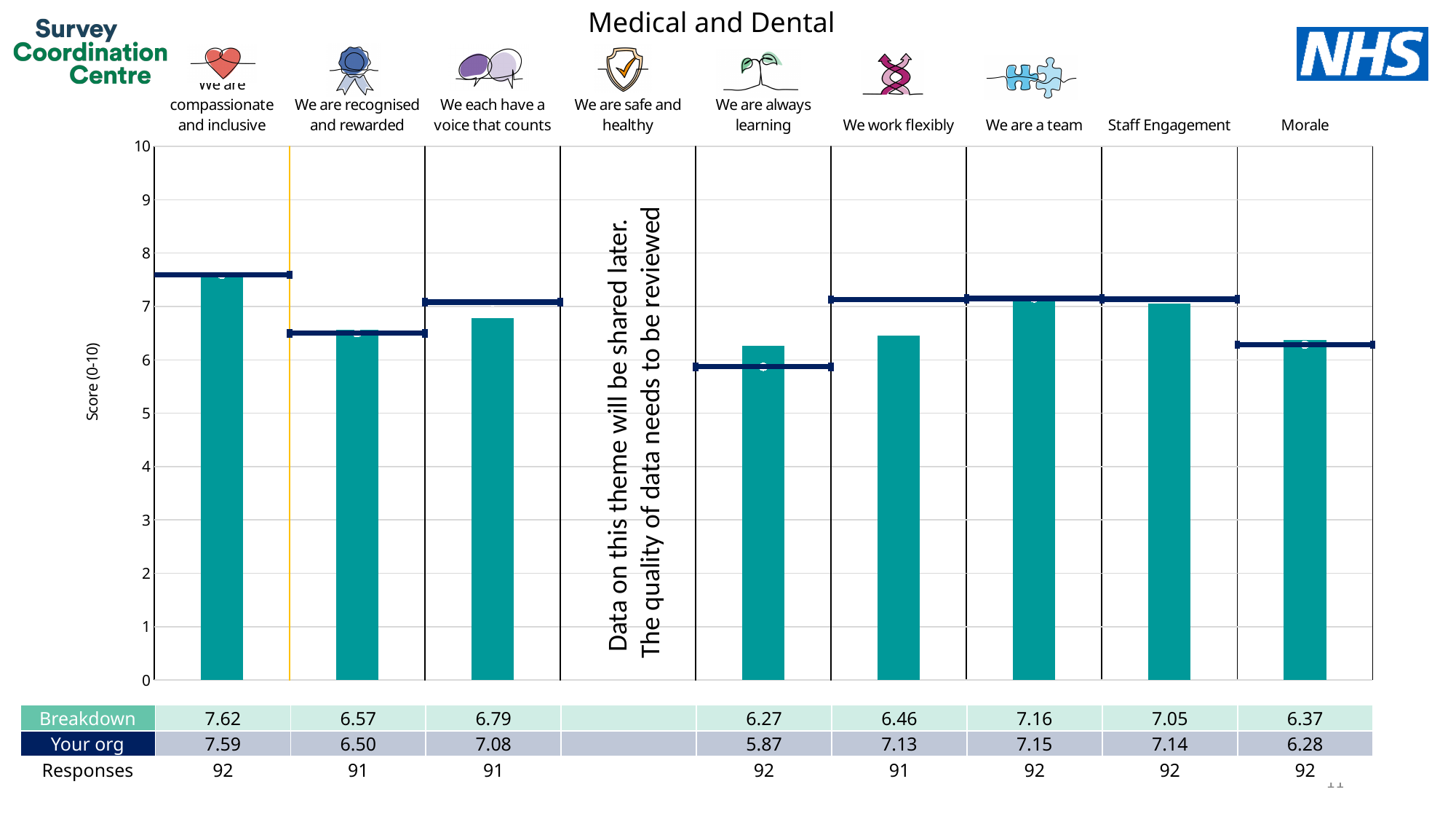
What kind of chart is shown on the slide? bar chart Which theme has the lowest Your org score? We are always learning Which theme has the highest Breakdown score? We are compassionate and inclusive For Staff Engagement, which is larger: the Breakdown score or the Your org score? Your org How many responses are shown for 'We work flexibly'? 91 What is the difference between the Breakdown score and the Your org score for 'We are always learning'? 0.40 What is the title of the chart? Medical and Dental Is the Breakdown score for 'We work flexibly' greater or less than 7? less What is the Breakdown score for 'We are compassionate and inclusive'? 7.62 What is the difference between the Your org score and the Breakdown score for 'We each have a voice that counts'? 0.29 How many themes have a Breakdown bar plotted on the chart? 8 What is the Your org score for 'We are always learning'? 5.87